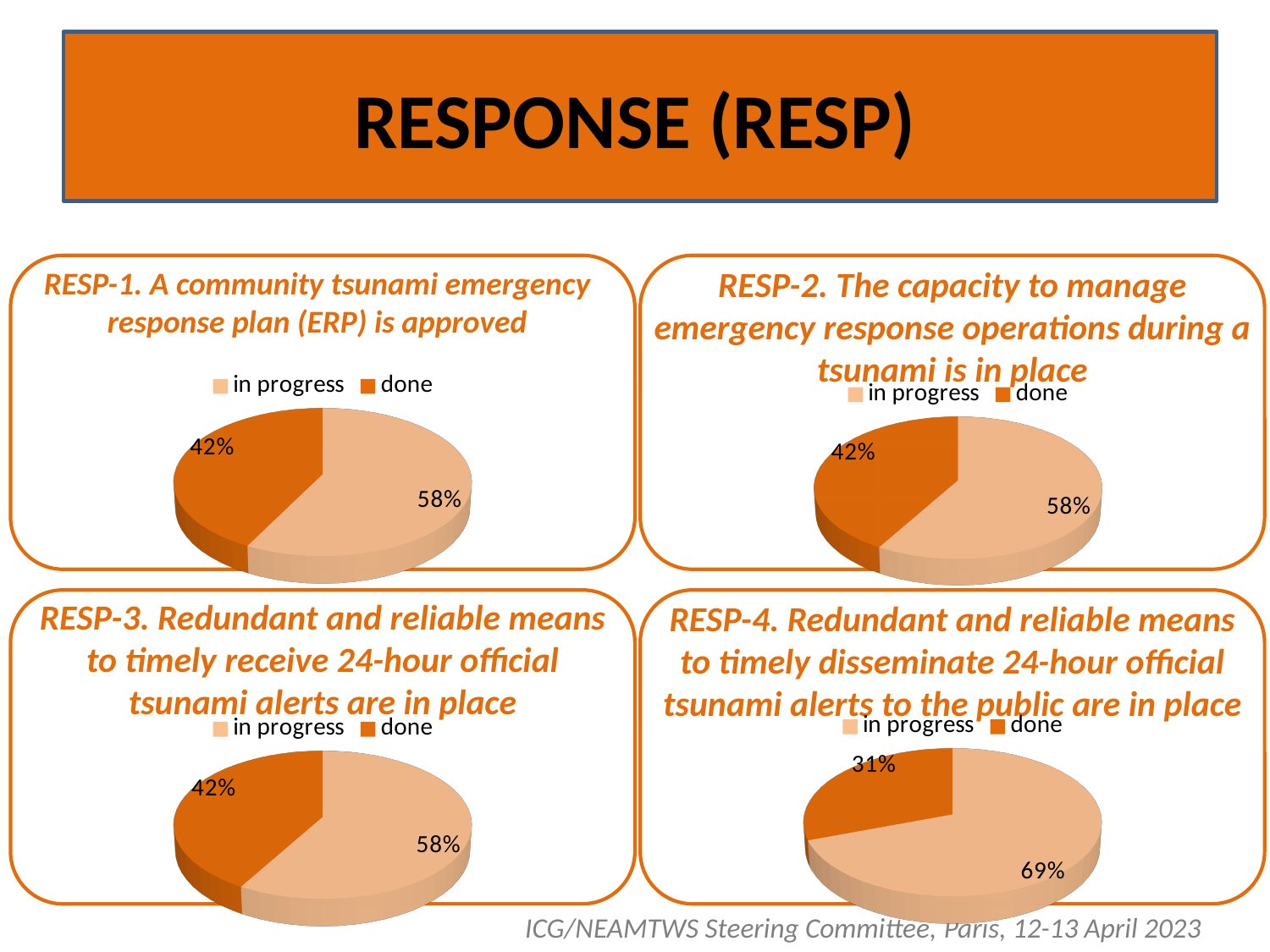
In the RESP-2 chart, what is the value for "done"? 42% How many pie charts are shown on the slide? 4 In the RESP-2 chart, what is the difference between the "in progress" and "done" values? 16% What kind of chart is used in the RESP-3 box? Pie chart In the RESP-4 chart, what is the difference between the "in progress" and "done" values? 38% In the RESP-4 chart, which slice is larger, "in progress" or "done"? in progress In the RESP-3 chart, which category has the smallest slice? done In the RESP-4 chart, what is the value for "in progress"? 69% In the RESP-1 chart, what is the value for "done"? 42% In the RESP-4 chart, what is the value for "done"? 31% In the RESP-1 chart, what share of the pie is labelled "in progress"? 58% How many categories does the legend of the RESP-1 chart list? 2